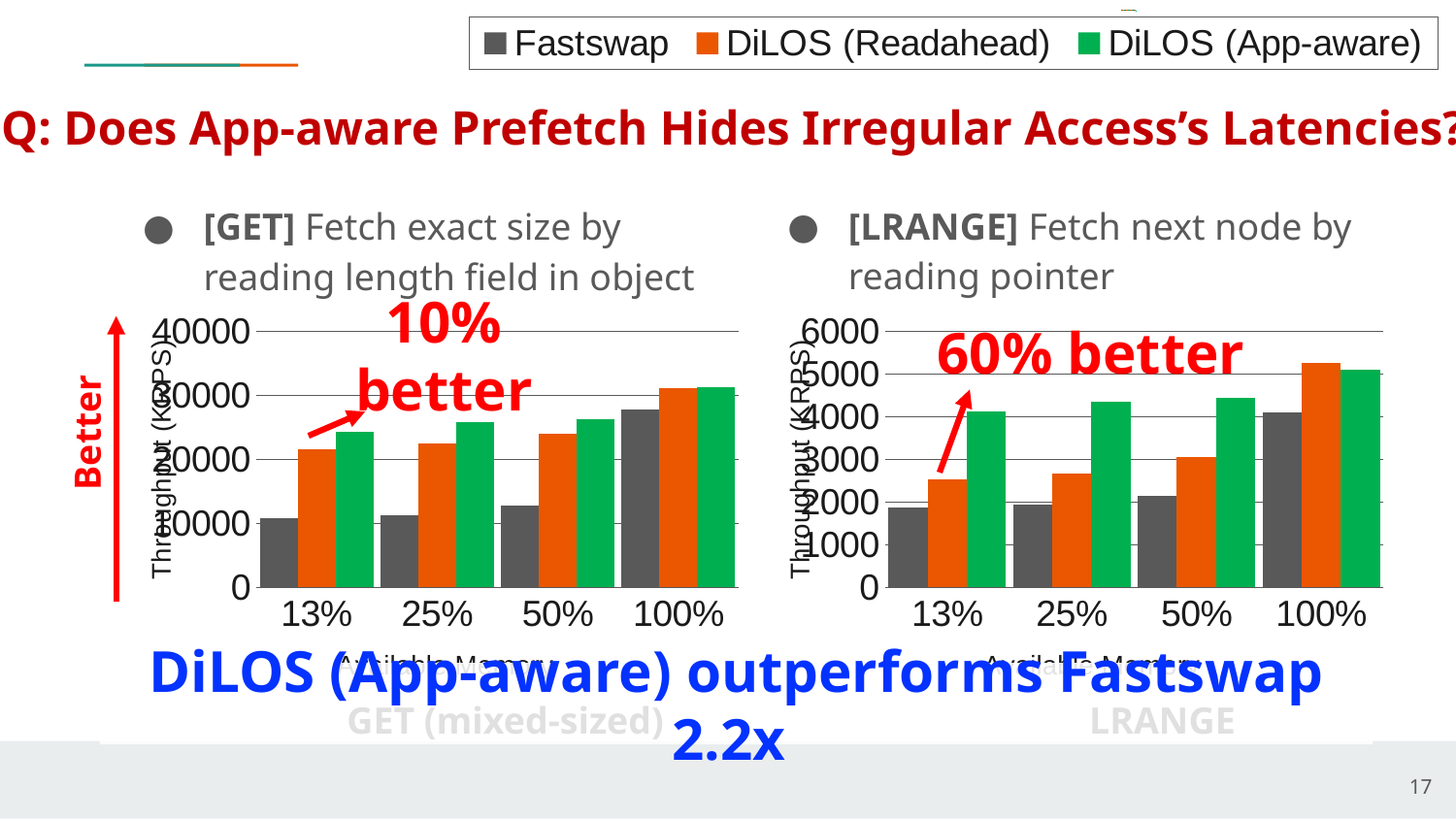
In the LRANGE chart on the right, is the DiLOS (Readahead) value at 100% greater or less than 5000? greater In the GET (mixed-sized) chart on the left, at which available-memory category is the Fastswap bar highest? 100% In the LRANGE chart on the right, do the Fastswap values rise or fall as available memory increases from 13% to 100%? rise What is the y-axis label of the LRANGE chart on the right? Throughput (KRPS) In the GET (mixed-sized) chart on the left, at 13% available memory, which is larger: Fastswap or DiLOS (App-aware)? DiLOS (App-aware) In the LRANGE chart on the right, is the DiLOS (App-aware) value at 13% greater or less than 3000? greater How many series does the legend list? 3 What kind of chart is the GET (mixed-sized) chart on the left? bar chart How many available-memory categories are shown on the x axis of the LRANGE chart on the right? 4 In the LRANGE chart on the right, is the Fastswap value at 13% greater or less than 3000? less